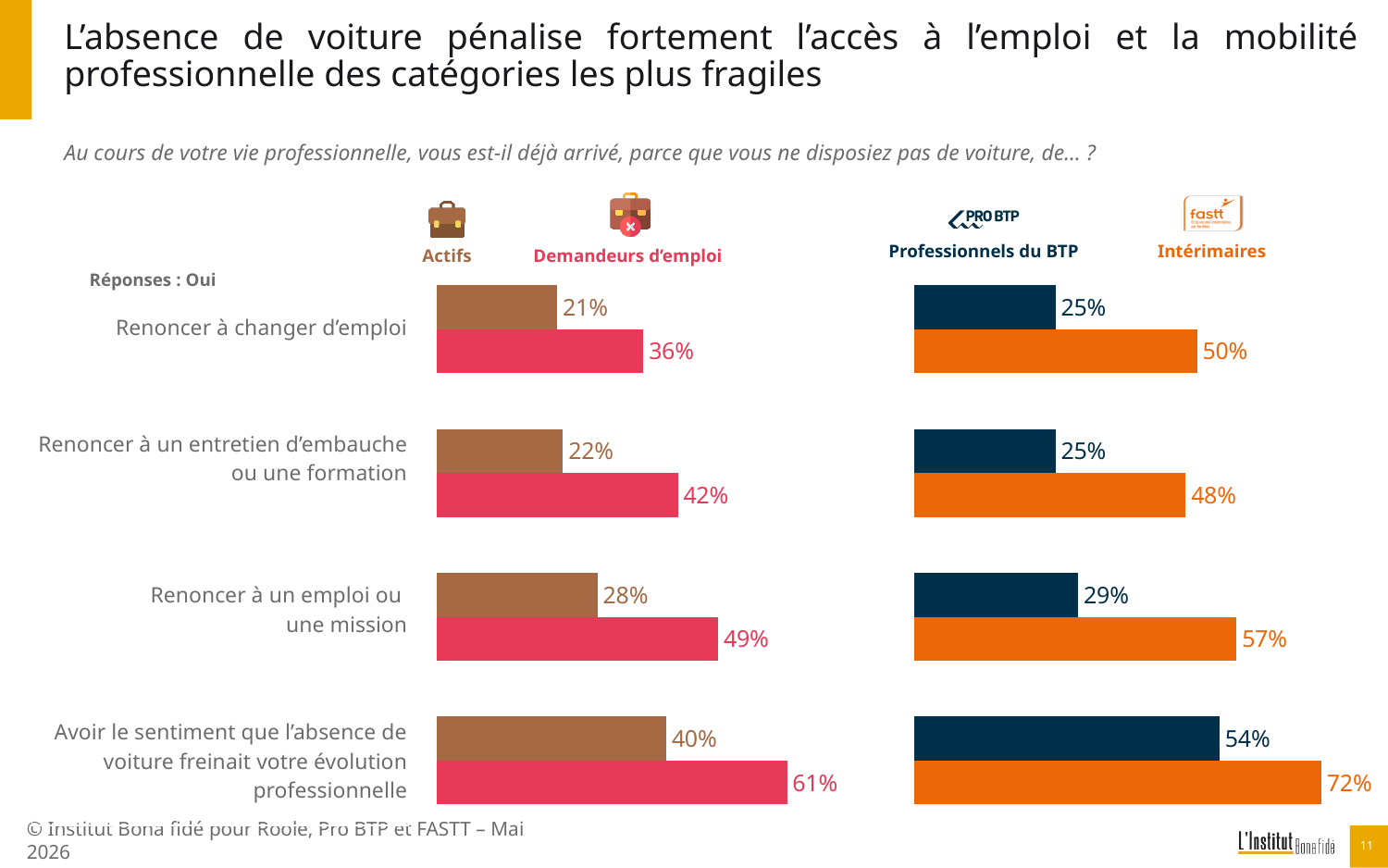
In the right chart (Professionnels du BTP / Intérimaires), which is larger for "Renoncer à un emploi ou une mission": Professionnels du BTP or Intérimaires? Intérimaires In the left chart (Actifs / Demandeurs d'emploi), which category has the lowest value for Actifs? Renoncer à changer d'emploi In the left chart (Actifs / Demandeurs d'emploi), what is the difference between Demandeurs d'emploi and Actifs for "Avoir le sentiment que l'absence de voiture freinait votre évolution professionnelle"? 21 percentage points In the right chart (Professionnels du BTP / Intérimaires), what is the value for Intérimaires for "Renoncer à un entretien d'embauche ou une formation"? 48% In the right chart (Professionnels du BTP / Intérimaires), what colour are the bars for Intérimaires? Orange In the left chart (Actifs / Demandeurs d'emploi), what is the value for Demandeurs d'emploi for "Renoncer à changer d'emploi"? 36% In the right chart (Professionnels du BTP / Intérimaires), which category has the highest value for Professionnels du BTP? Avoir le sentiment que l'absence de voiture freinait votre évolution professionnelle How many series does the right chart (Professionnels du BTP / Intérimaires) show? 2 In the right chart (Professionnels du BTP / Intérimaires), what is the difference between Intérimaires and Professionnels du BTP for "Renoncer à changer d'emploi"? 25 percentage points What kind of chart is the left chart (Actifs / Demandeurs d'emploi)? Bar chart How many categories (questions) are shown in the left chart (Actifs / Demandeurs d'emploi)? 4 In the left chart (Actifs / Demandeurs d'emploi), what is the value for Actifs for "Renoncer à un emploi ou une mission"? 28%